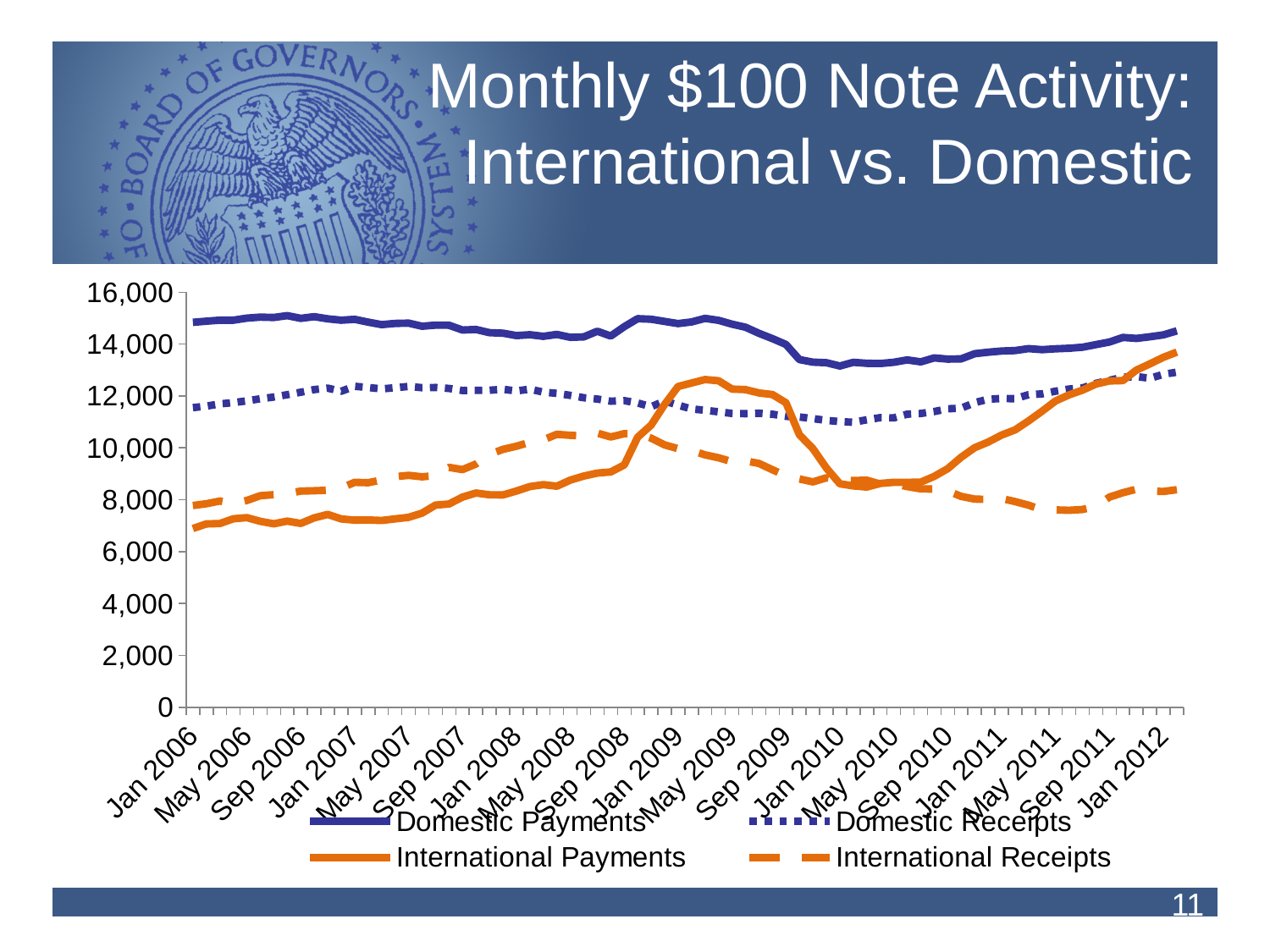
Is the value for International Payments in Jan 2012 greater or less than 12,000? greater How many series does the legend list? 4 Which series is drawn as an orange dashed line? International Receipts Is the value for Domestic Payments in Jan 2006 greater or less than 14,000? greater Which series has the lowest value in Jan 2012? International Receipts Is the value for Domestic Receipts in Jan 2010 greater or less than 12,000? less What kind of chart is shown on the slide? Line chart Do the values for International Payments rise or fall from Jan 2010 to Jan 2012? Rise What is the title of the slide's chart? Monthly $100 Note Activity: International vs. Domestic In Jan 2006, which is larger: Domestic Payments or International Payments? Domestic Payments Which series has the highest values across the whole period shown? Domestic Payments